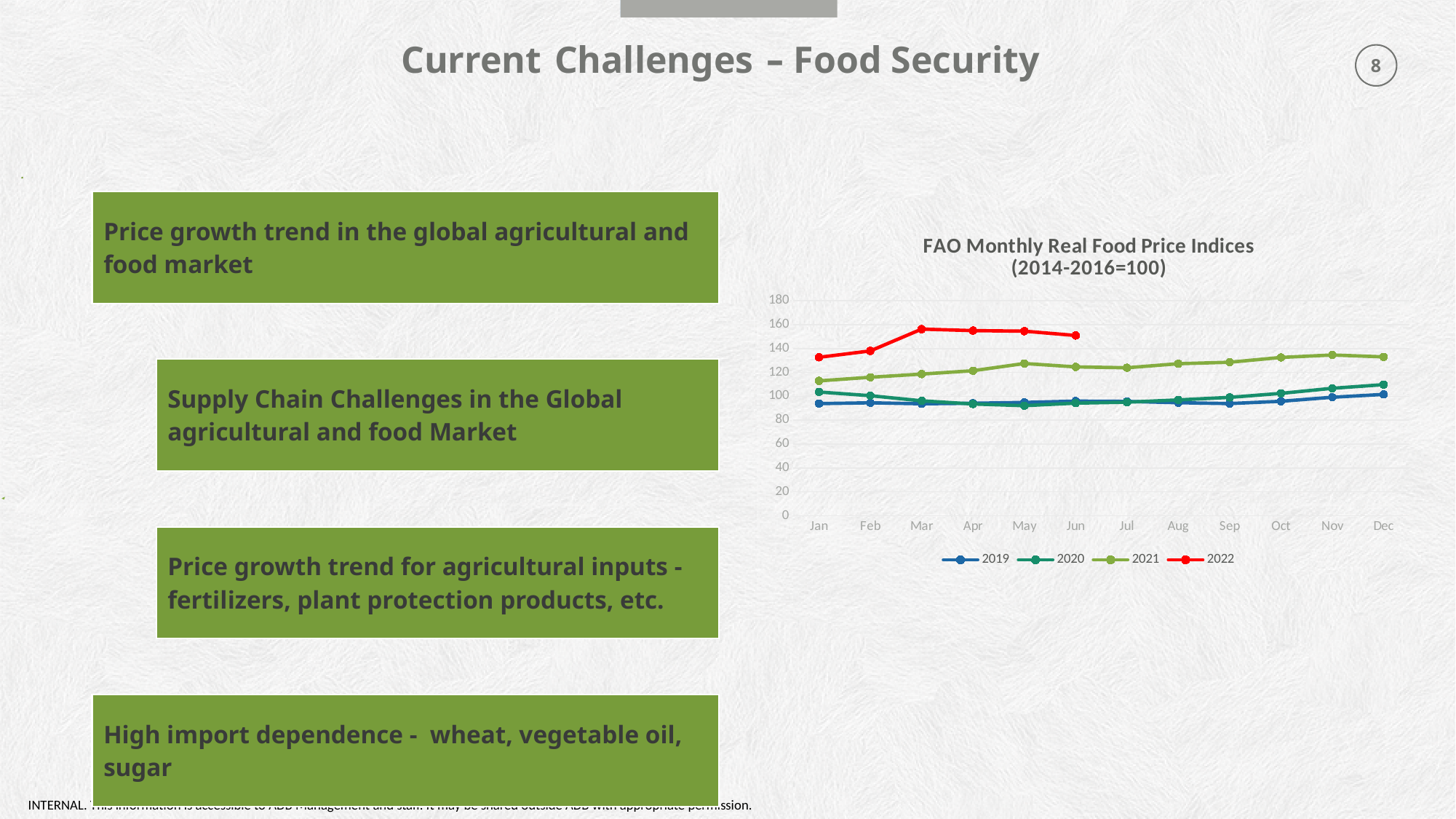
How many series does the chart legend list? 4 Is the value for 2019 in January greater or less than 100? less Does the 2022 series rise or fall from January to March? rise Which series has the highest value in March? 2022 Which series has the highest value in December? 2021 Is the value for 2021 in November greater or less than 120? greater What kind of chart is shown on the slide? line chart Is the value for 2022 in March greater or less than 140? greater Which is larger in June, the value for 2022 or the value for 2021? 2022 How many months are shown on the x axis of the chart? 12 What is the title of the chart? FAO Monthly Real Food Price Indices (2014-2016=100) How many data points are plotted for the 2022 series? 6